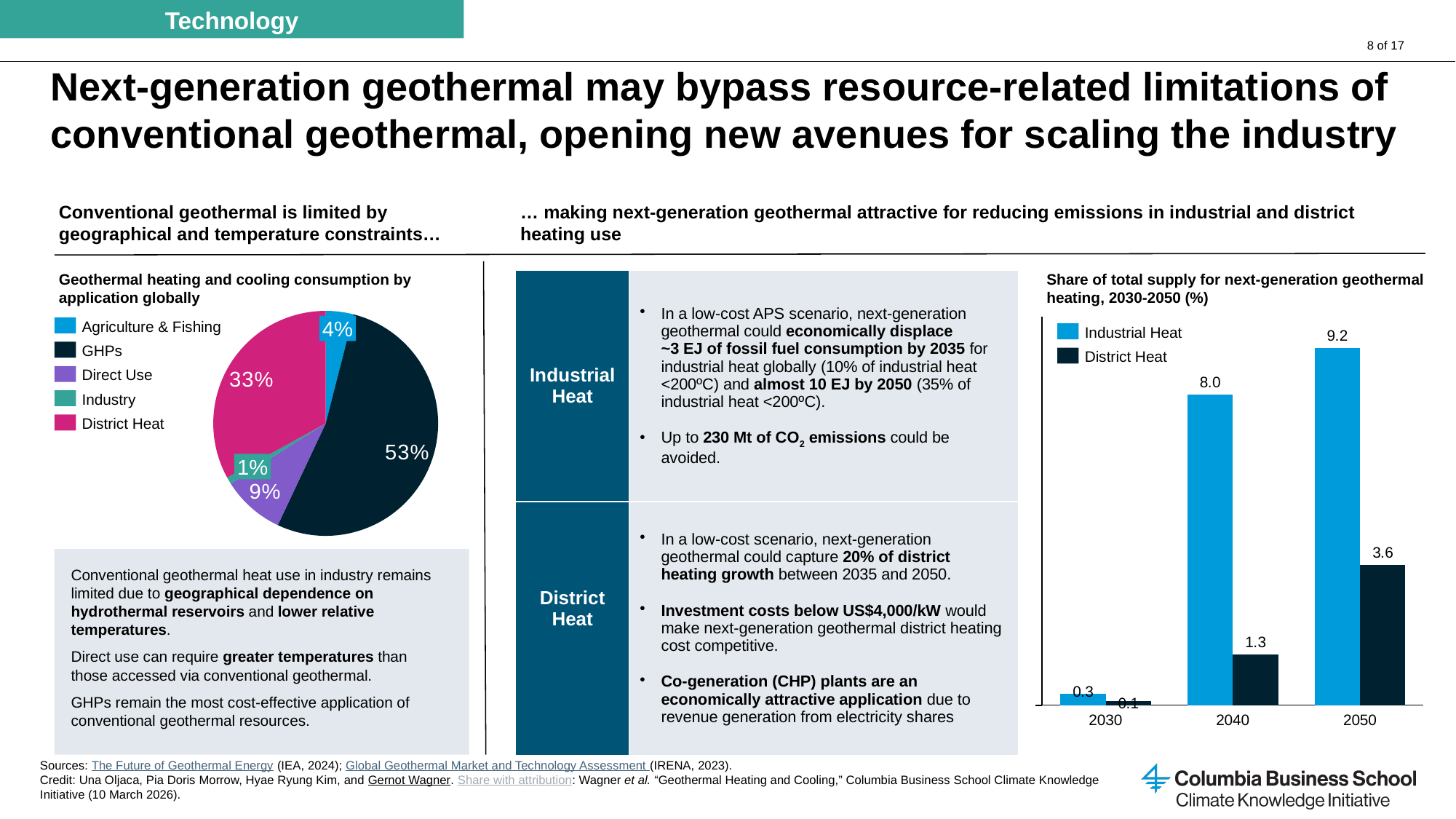
In the pie chart 'Geothermal heating and cooling consumption by application globally', which application has the largest share? GHPs In the pie chart 'Geothermal heating and cooling consumption by application globally', which application has the smallest share? Industry In the bar chart 'Share of total supply for next-generation geothermal heating, 2030-2050 (%)', how many series does the legend list? 2 In the bar chart 'Share of total supply for next-generation geothermal heating, 2030-2050 (%)', does the District Heat value rise or fall from 2030 to 2050? rise In the pie chart 'Geothermal heating and cooling consumption by application globally', what share does District Heat account for? 33% In the bar chart 'Share of total supply for next-generation geothermal heating, 2030-2050 (%)', what is the value for District Heat in 2050? 3.6 In the bar chart 'Share of total supply for next-generation geothermal heating, 2030-2050 (%)', what is the difference between Industrial Heat and District Heat in 2050? 5.6 In the pie chart 'Geothermal heating and cooling consumption by application globally', how many applications are shown in the legend? 5 What kind of chart is the chart on the right of the slide, 'Share of total supply for next-generation geothermal heating, 2030-2050 (%)'? bar chart In the pie chart 'Geothermal heating and cooling consumption by application globally', how many percentage points larger is the Direct Use share than the Agriculture & Fishing share? 5 In the bar chart 'Share of total supply for next-generation geothermal heating, 2030-2050 (%)', what is the value for Industrial Heat in 2040? 8.0 In the pie chart 'Geothermal heating and cooling consumption by application globally', what share do GHPs account for? 53%